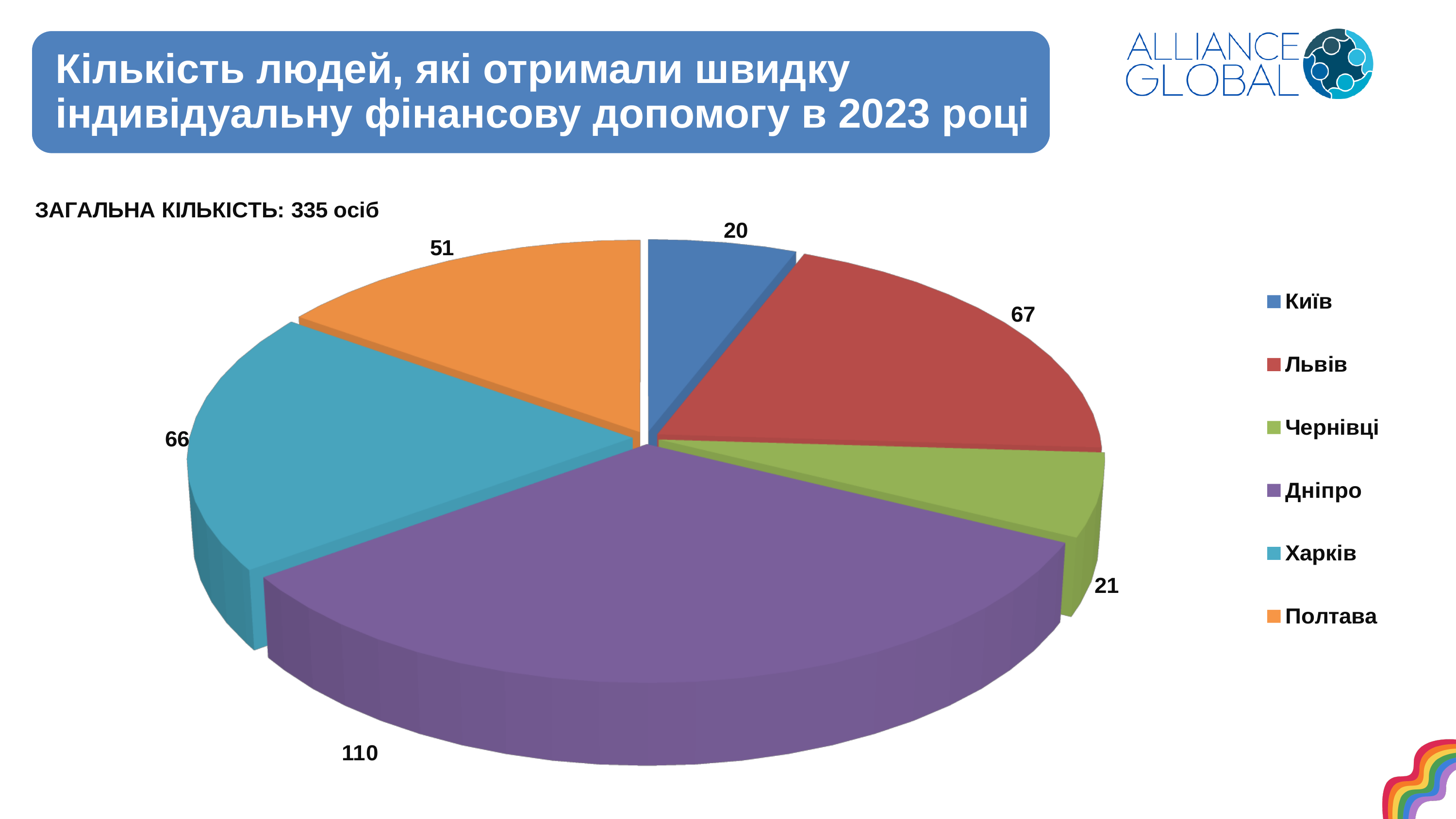
What is the value for Чернівці? 21 How many people received rapid individual financial assistance in Дніпро? 110 Which city has the largest slice of the pie? Дніпро What kind of chart is shown on the slide? pie chart What is the difference between the values for Львів and Київ? 47 How many cities are shown in the pie chart? 6 What total number of people is stated on the slide? 335 осіб Which city has the smallest slice of the pie? Київ What is the value for Львів? 67 What is the difference between the values for Дніпро and Харків? 44 What is the value for Полтава? 51 Which is larger, the value for Полтава or the value for Чернівці? Полтава